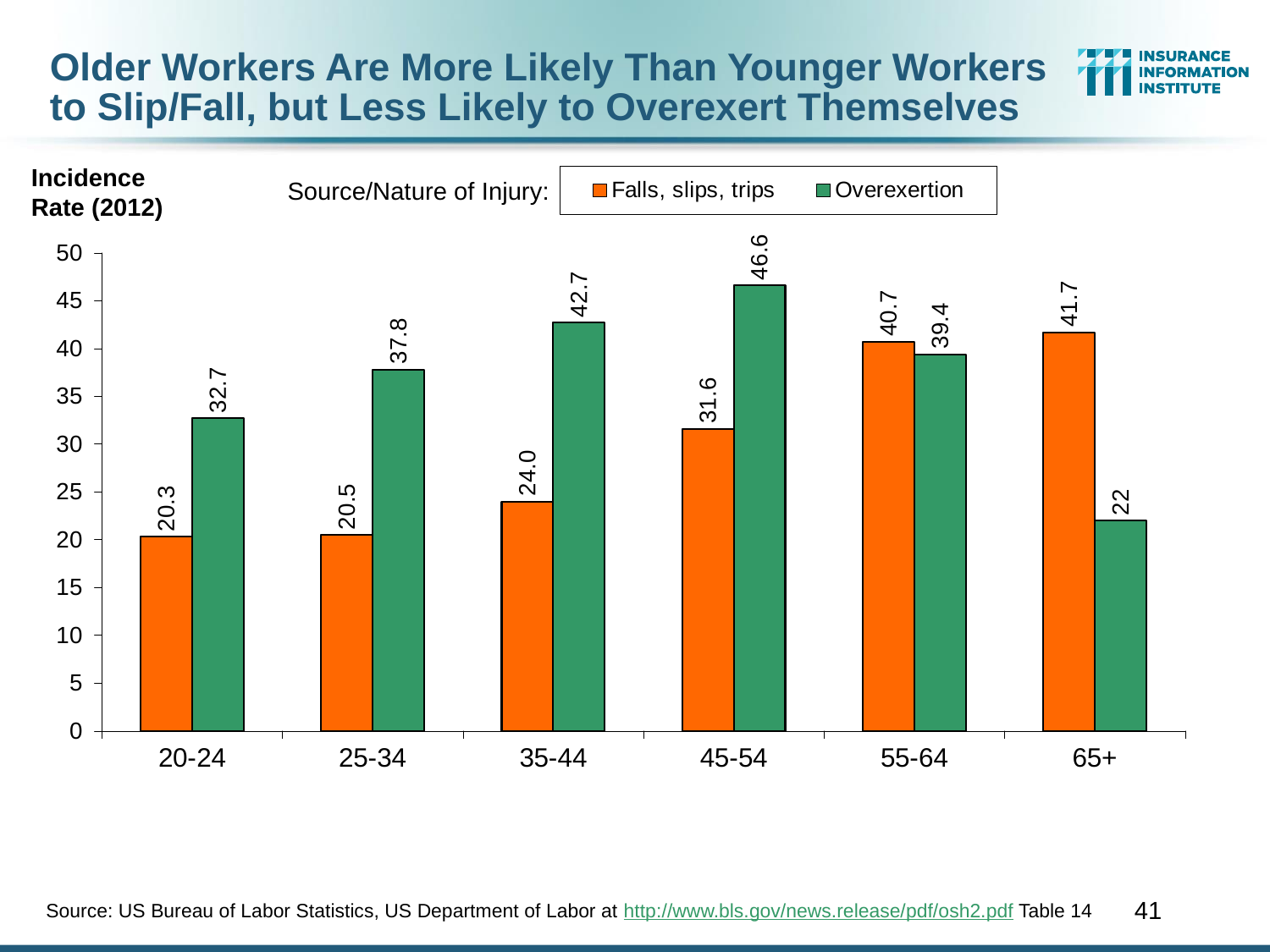
What kind of chart is shown on the slide? Bar chart What is the difference between the Overexertion and Falls, slips, trips rates for the 35-44 age group? 18.7 Which age group has the highest Overexertion incidence rate? 45-54 Which age group has the lowest Falls, slips, trips incidence rate? 20-24 Do the Falls, slips, trips values rise or fall as age group increases along the x axis? Rise What is the incidence rate for Falls, slips, trips in the 20-24 age group? 20.3 What is the incidence rate for Falls, slips, trips in the 65+ age group? 41.7 How many age groups are shown on the x axis? 6 How many series does the legend list? 2 What is the incidence rate for Overexertion in the 45-54 age group? 46.6 Which is larger for the 55-64 age group: Falls, slips, trips or Overexertion? Falls, slips, trips Which age group has the lowest Overexertion incidence rate? 65+